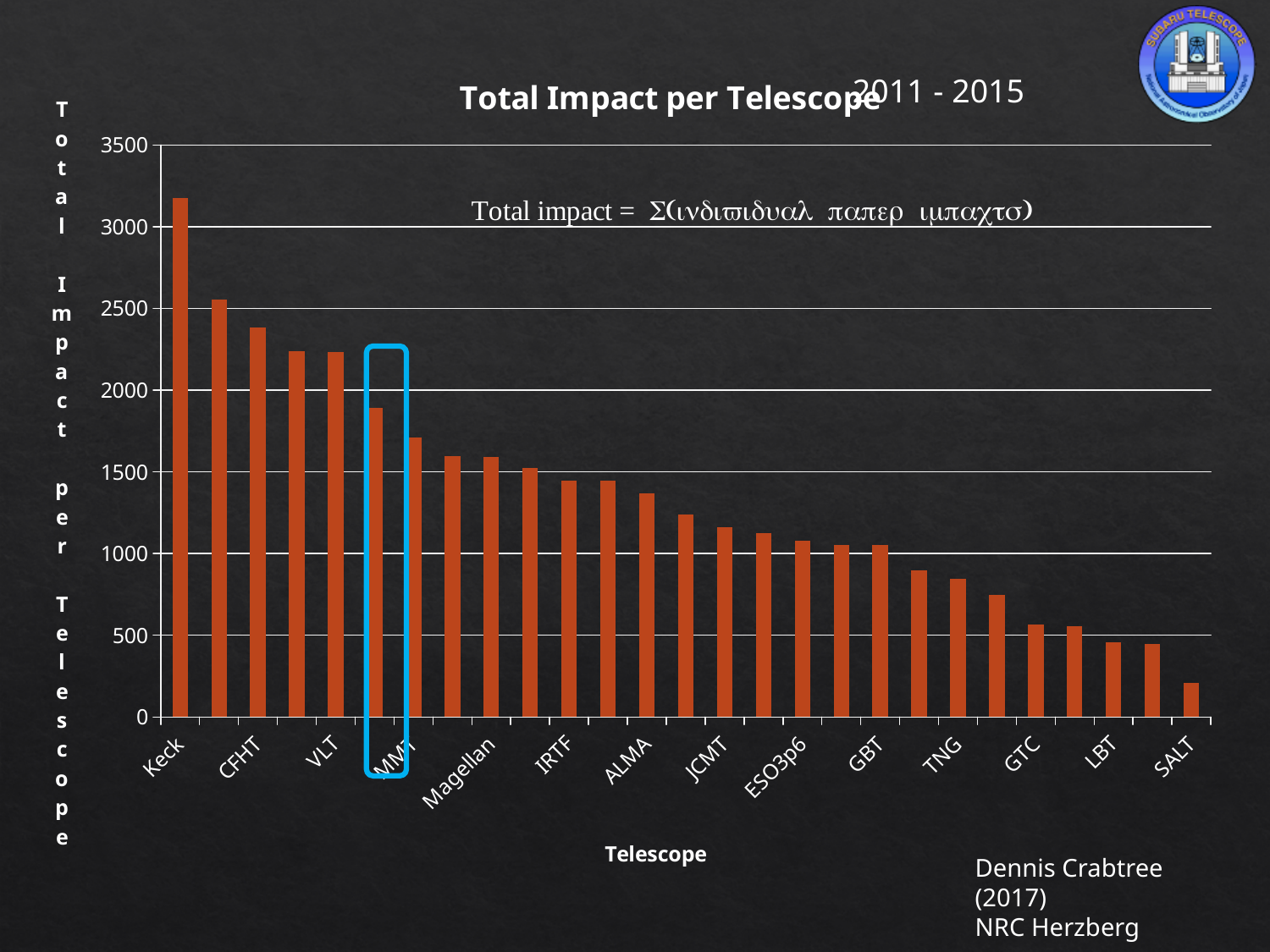
Is the value for ALMA greater or less than 1500? less Which telescope has the lowest total impact? SALT Is the value for CFHT greater or less than 2500? less What kind of chart is shown on the slide? bar chart Which telescope has the highest total impact? Keck Is the value for TNG greater or less than 1000? less What is the title of the chart? Total Impact per Telescope Do the values rise or fall moving from left to right along the x axis? fall What is the label of the x axis? Telescope Which has a higher total impact, CFHT or VLT? CFHT